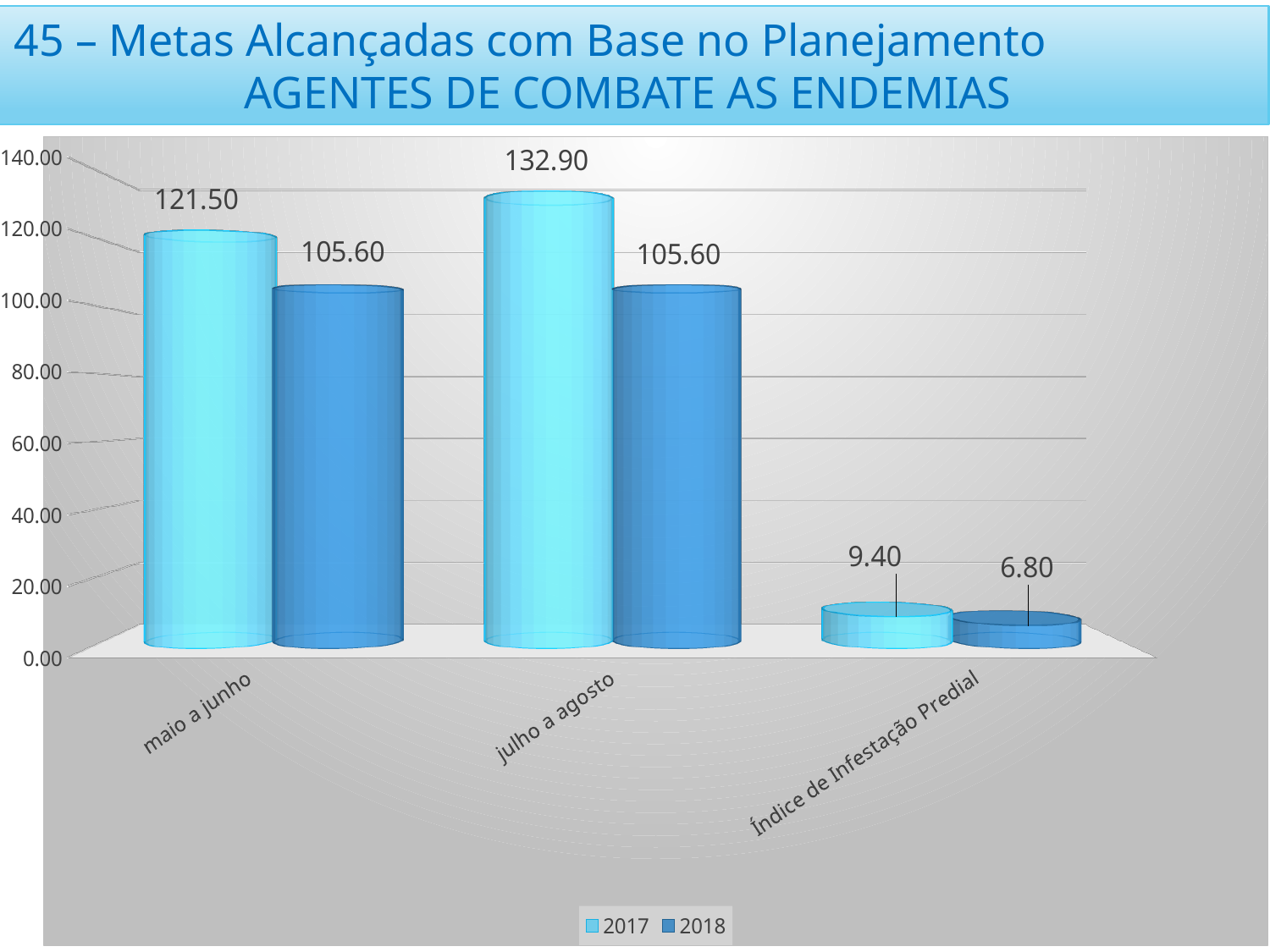
What is the value for 2018 in the 'Índice de Infestação Predial' category? 6.80 What is the value for 2017 in the 'maio a junho' category? 121.50 How many series does the legend list? 2 What is the difference between the 2017 and 2018 values in the 'maio a junho' category? 15.90 How many categories are shown on the x axis? 3 What is the value for 2017 in the 'Índice de Infestação Predial' category? 9.40 Which category has the lowest value for the 2018 series? Índice de Infestação Predial What kind of chart is shown on the slide? bar chart What is the difference between the 2017 and 2018 values in the 'julho a agosto' category? 27.30 Which category has the highest value for the 2017 series? julho a agosto Which is larger in the 'maio a junho' category, the 2017 value or the 2018 value? 2017 What is the value for 2018 in the 'julho a agosto' category? 105.60